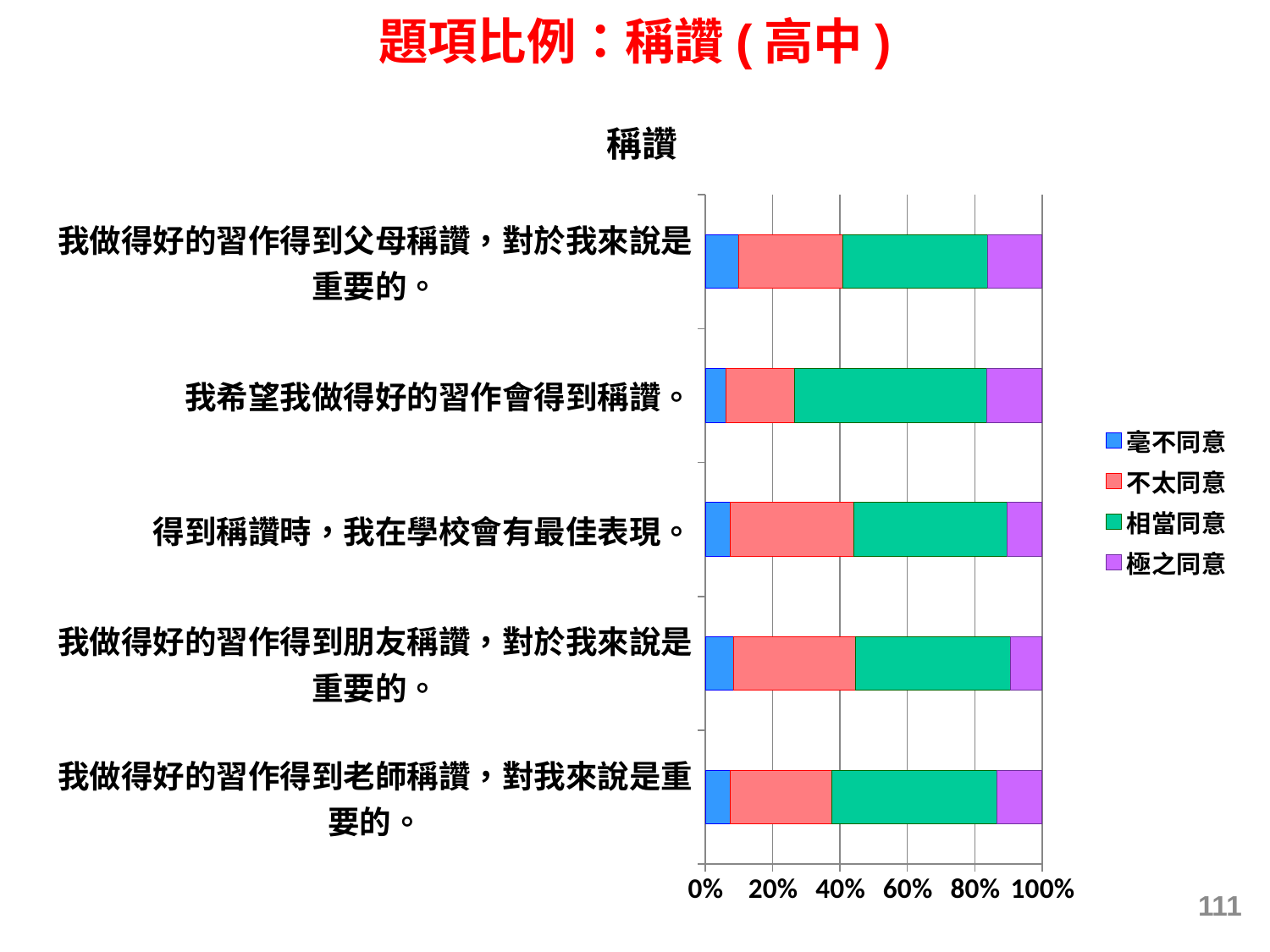
Which statement has the smallest 不太同意 segment? 我希望我做得好的習作會得到稱讚。 Which legend entry is shown in green? 相當同意 How many series does the legend list? 4 How many statements (categories) are plotted in the chart? 5 Which has the larger 相當同意 share: 「我希望我做得好的習作會得到稱讚。」 or 「我做得好的習作得到父母稱讚，對於我來說是重要的。」? 我希望我做得好的習作會得到稱讚。 Is the 不太同意 share for 「我希望我做得好的習作會得到稱讚。」 greater or less than 40%? less Which statement has the largest 相當同意 segment? 我希望我做得好的習作會得到稱讚。 Is the 毫不同意 share for 「我做得好的習作得到父母稱讚，對於我來說是重要的。」 greater or less than 20%? less What is the title of the chart? 稱讚 What kind of chart is shown on the slide? stacked bar chart What does each stacked bar total on the x axis? 100% Is the 相當同意 share for 「我希望我做得好的習作會得到稱讚。」 greater or less than 40%? greater